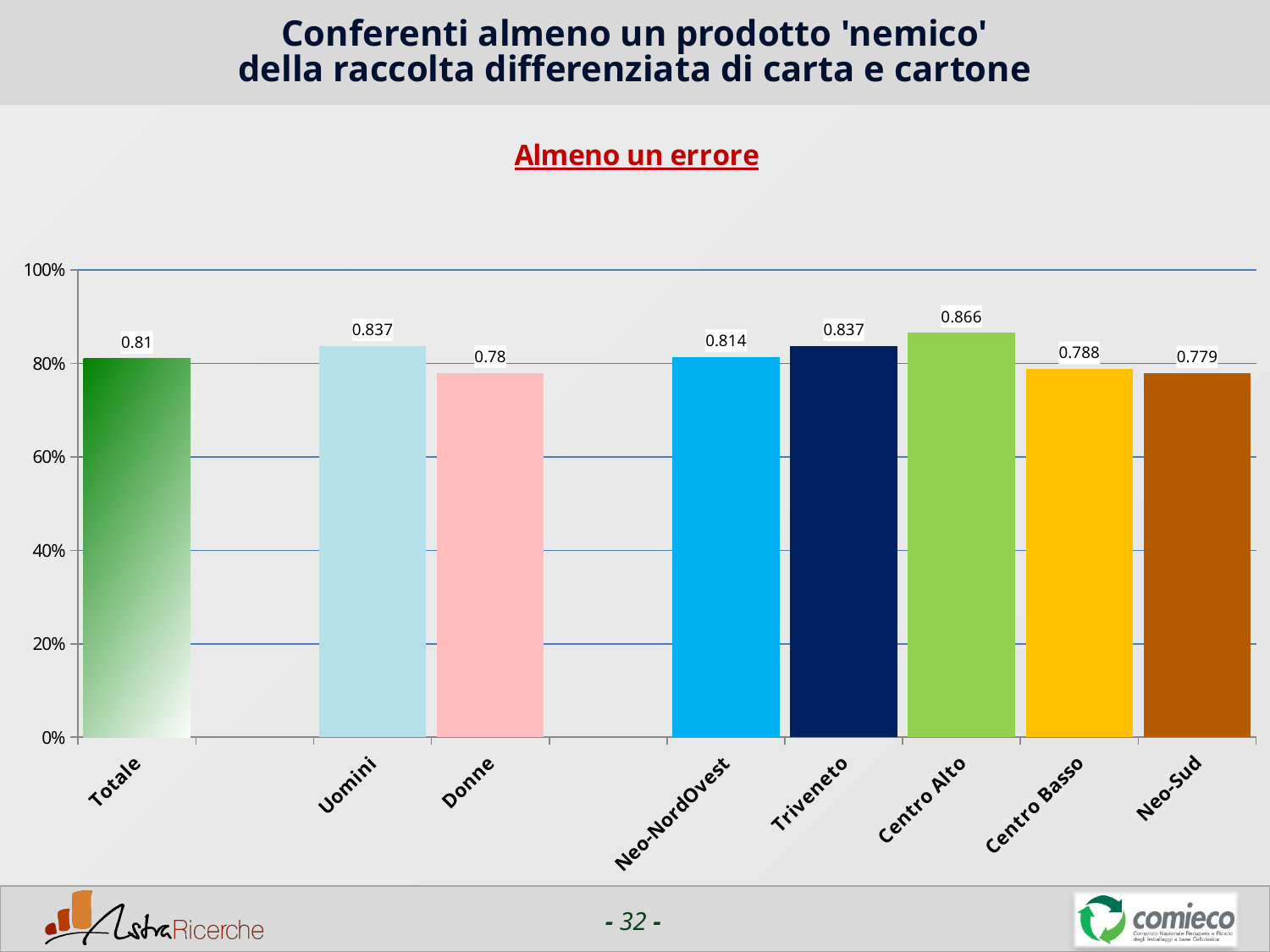
What is the value for Donne? 0.78 What is the difference between the values for Uomini and Donne? 0.057 What kind of chart is shown on the slide? bar chart How many categories are shown on the x axis? 8 What is the red underlined subtitle above the chart? Almeno un errore Is the value for Donne greater or less than 80%? less Which category has the highest value? Centro Alto What is the value for Neo-NordOvest? 0.814 What is the value for Centro Alto? 0.866 Which is larger, the value for Uomini or the value for Donne? Uomini What is the difference between the values for Centro Alto and Neo-Sud? 0.087 What is the value for Totale? 0.81